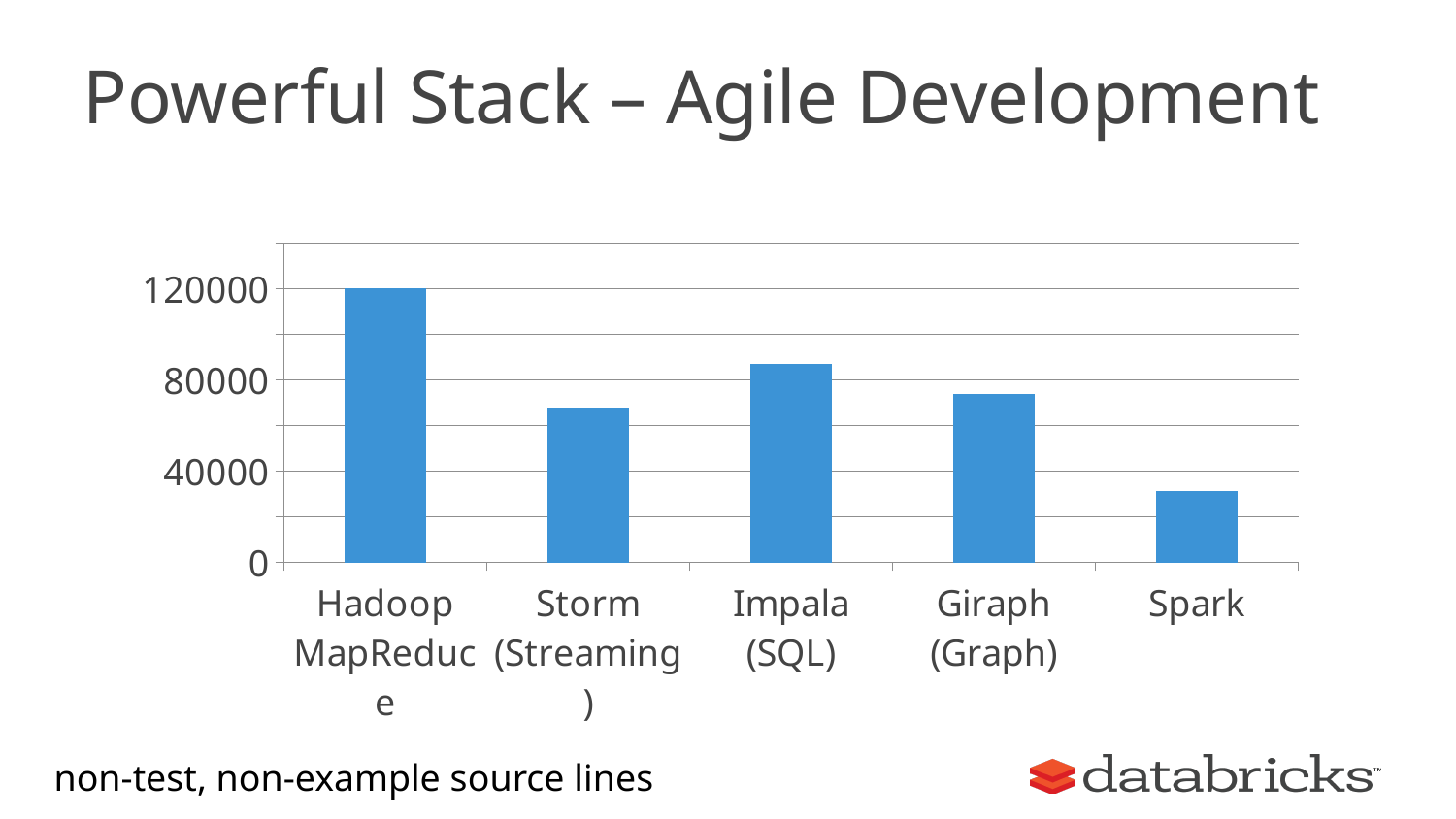
Is the value for Giraph (Graph) greater or less than 40000? greater Which category has the highest value in the chart? Hadoop MapReduce Is the value for Spark greater or less than 40000? less Which has a larger value, Spark or Giraph (Graph)? Giraph (Graph) Is the value for Impala (SQL) greater or less than 80000? greater What is the value for Hadoop MapReduce? 120000 Which category has the lowest value in the chart? Spark Which has a larger value, Impala (SQL) or Storm (Streaming)? Impala (SQL) What is the title of the slide containing the chart? Powerful Stack – Agile Development How many categories are plotted in the chart? 5 What kind of chart is shown on the slide? bar chart